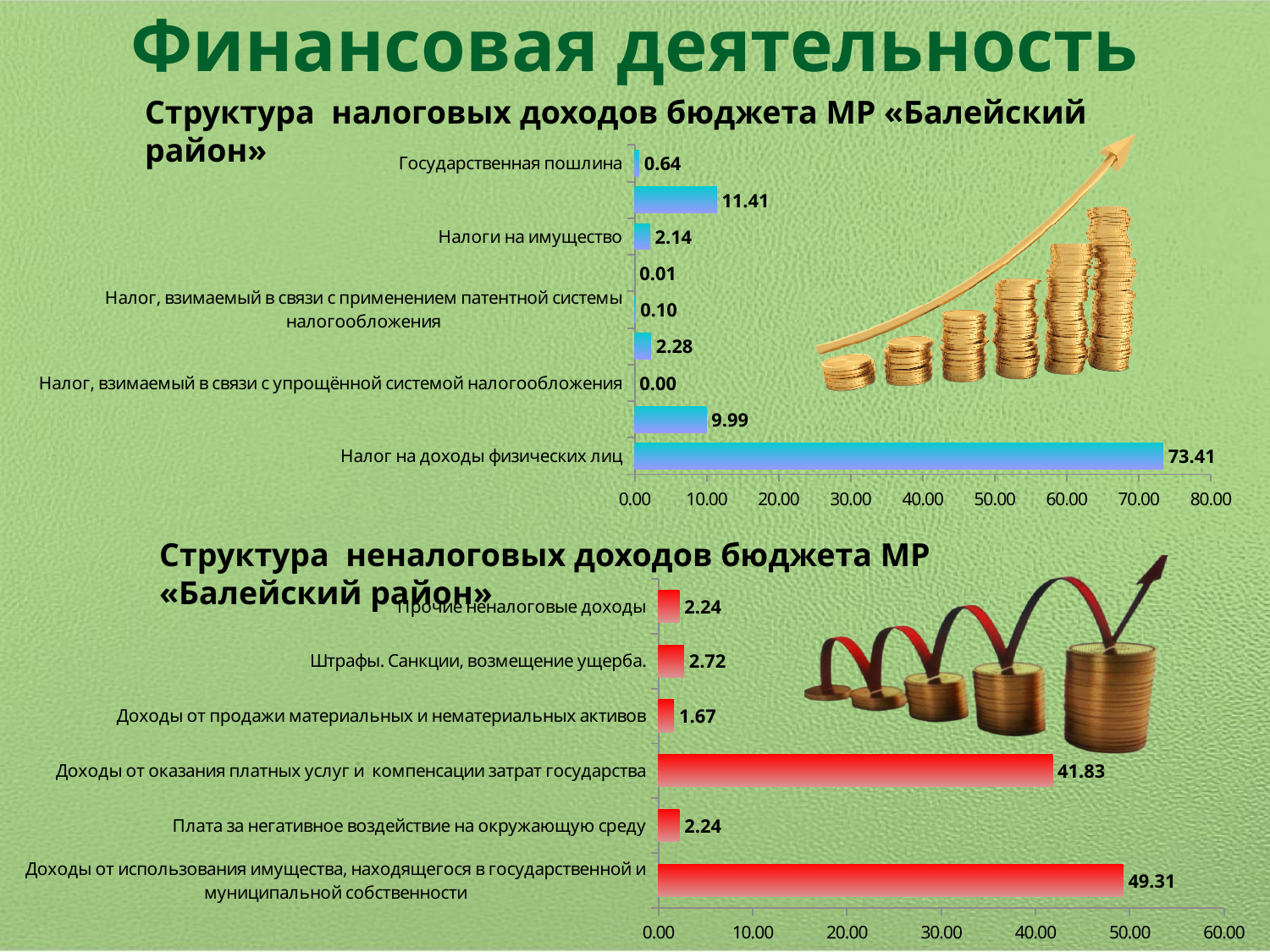
On the chart 'Структура налоговых доходов бюджета МР «Балейский район»', what kind of chart is shown? Bar chart On the chart 'Структура неналоговых доходов бюджета МР «Балейский район»', which is larger: 'Штрафы. Санкции, возмещение ущерба.' or 'Прочие неналоговые доходы'? Штрафы. Санкции, возмещение ущерба. On the chart 'Структура неналоговых доходов бюджета МР «Балейский район»', how many categories are shown? 6 On the chart 'Структура неналоговых доходов бюджета МР «Балейский район»', what is the value for 'Доходы от оказания платных услуг и компенсации затрат государства'? 41.83 On the chart 'Структура налоговых доходов бюджета МР «Балейский район»', what is the value for 'Государственная пошлина'? 0.64 On the chart 'Структура неналоговых доходов бюджета МР «Балейский район»', which category has the highest value? Доходы от использования имущества, находящегося в государственной и муниципальной собственности On the chart 'Структура налоговых доходов бюджета МР «Балейский район»', which category has the highest value? Налог на доходы физических лиц On the chart 'Структура неналоговых доходов бюджета МР «Балейский район»', what is the value for 'Штрафы. Санкции, возмещение ущерба.'? 2.72 On the chart 'Структура налоговых доходов бюджета МР «Балейский район»', what is the value for 'Налоги на имущество'? 2.14 On the chart 'Структура неналоговых доходов бюджета МР «Балейский район»', which category has the lowest value? Доходы от продажи материальных и нематериальных активов On the chart 'Структура неналоговых доходов бюджета МР «Балейский район»', what is the difference between 'Доходы от использования имущества, находящегося в государственной и муниципальной собственности' and 'Доходы от оказания платных услуг и компенсации затрат государства'? 7.48 On the chart 'Структура налоговых доходов бюджета МР «Балейский район»', what is the value for 'Налог на доходы физических лиц'? 73.41